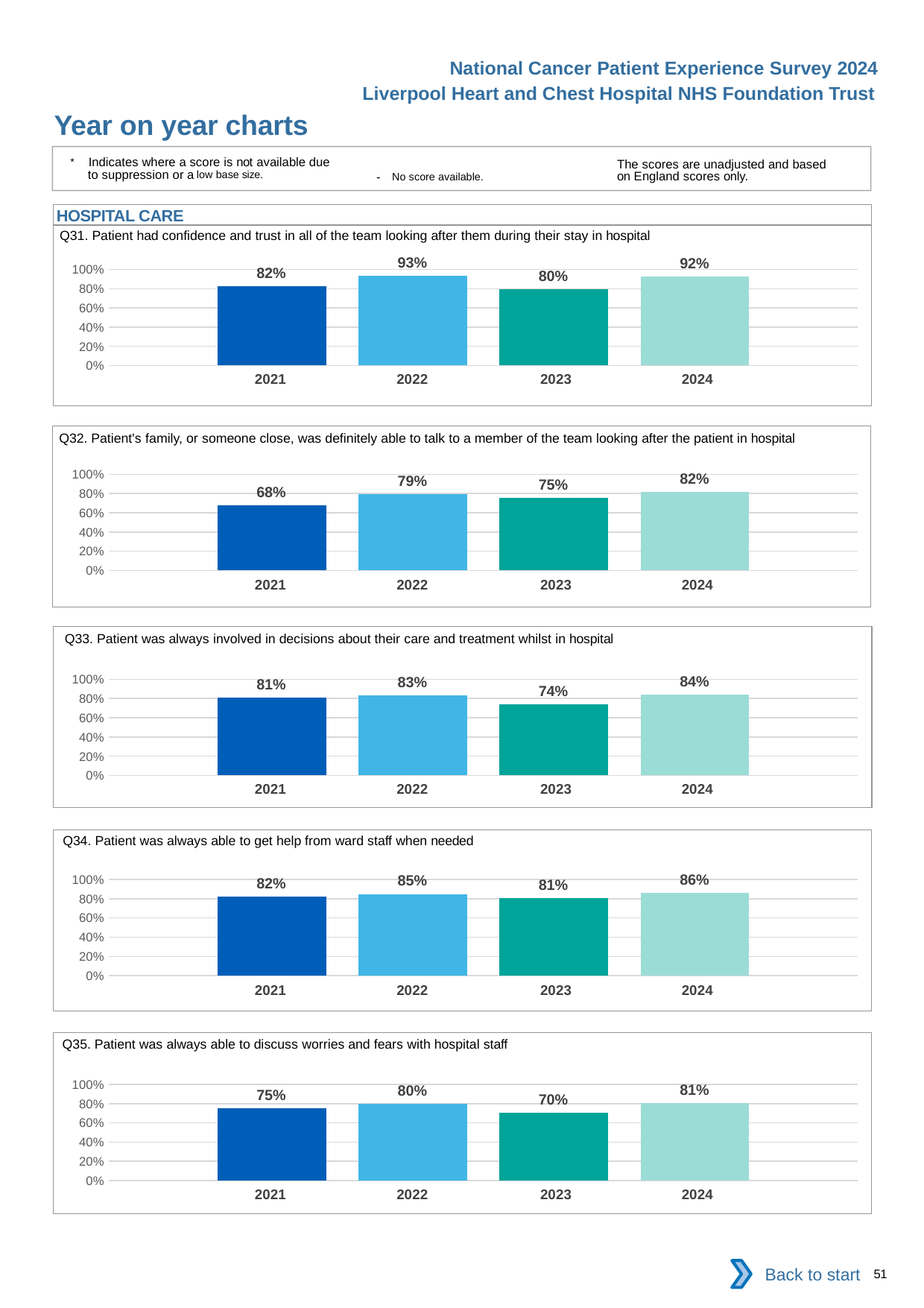
In the Q33 chart, which is larger, the value for 2022 or the value for 2024? 2024 In the Q35 chart, what is the value for 2023? 70% In the Q33 chart, what is the value for 2023? 74% In the Q32 chart, which year has the highest value? 2024 In the Q31 chart, which year has the lowest value? 2023 In the Q35 chart, what is the difference between the 2022 and 2023 values? 10 percentage points In the Q32 chart, what is the value for 2021? 68% In the Q34 chart, how many years are shown on the x axis? 4 In the Q34 chart, what is the value for 2024? 86% In the Q32 chart, what is the difference between the 2024 and 2021 values? 14 percentage points In the Q31 chart, what is the value for 2022? 93% What kind of chart is the Q35 chart? Bar chart